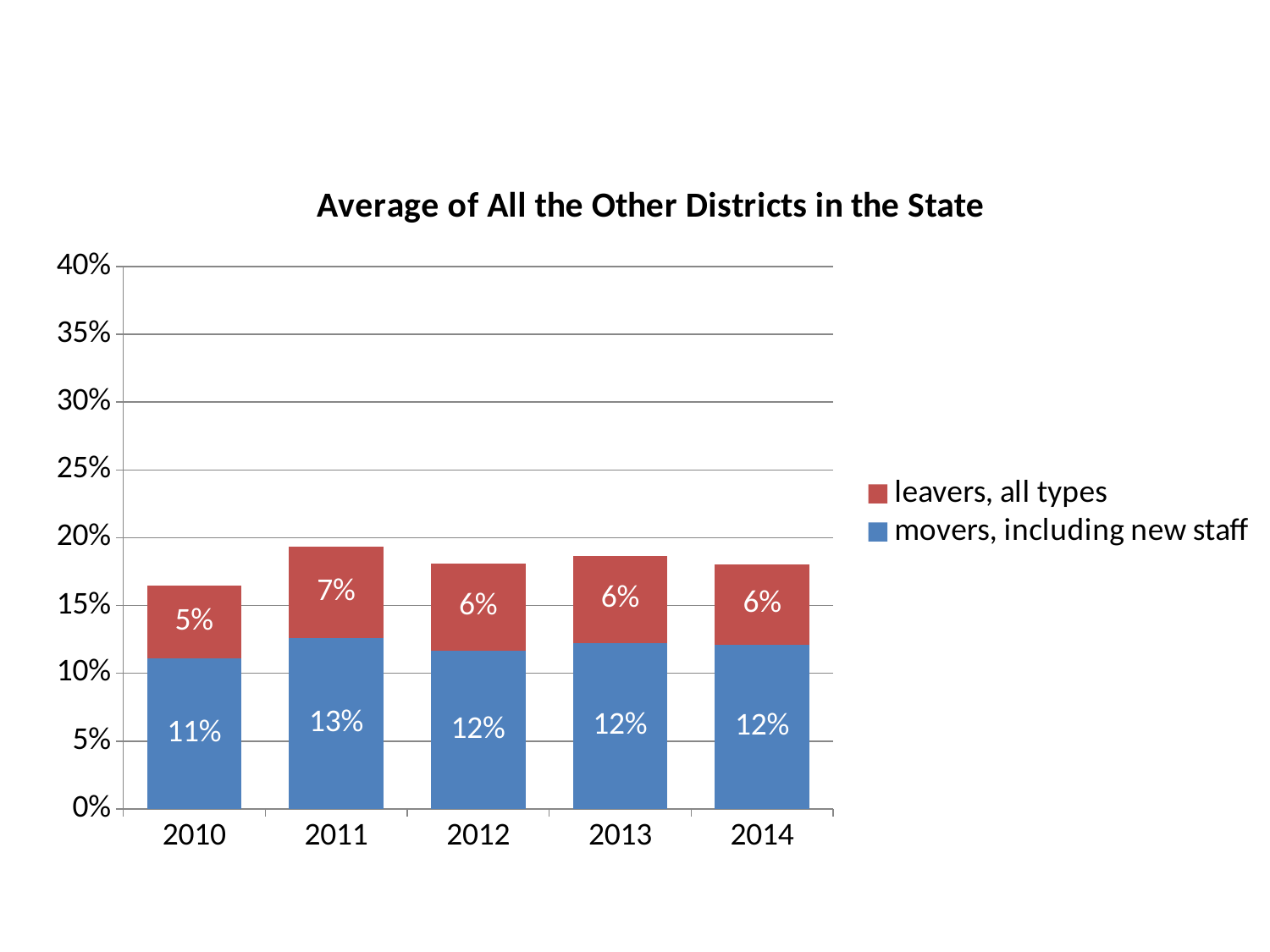
Which is larger: leavers, all types in 2011 or leavers, all types in 2012? 2011 What is the title of the chart? Average of All the Other Districts in the State What kind of chart is shown on the slide? stacked bar chart What is the difference between the movers, including new staff values for 2011 and 2010? 2% Is the total height of the 2010 bar greater or less than 20%? less What is the value for movers, including new staff in 2011? 13% In which year is the movers, including new staff value highest? 2011 How many years are shown on the x axis? 5 How many series does the legend list? 2 What is the value for leavers, all types in 2010? 5% What is the value for leavers, all types in 2014? 6% In which year is the leavers, all types value lowest? 2010